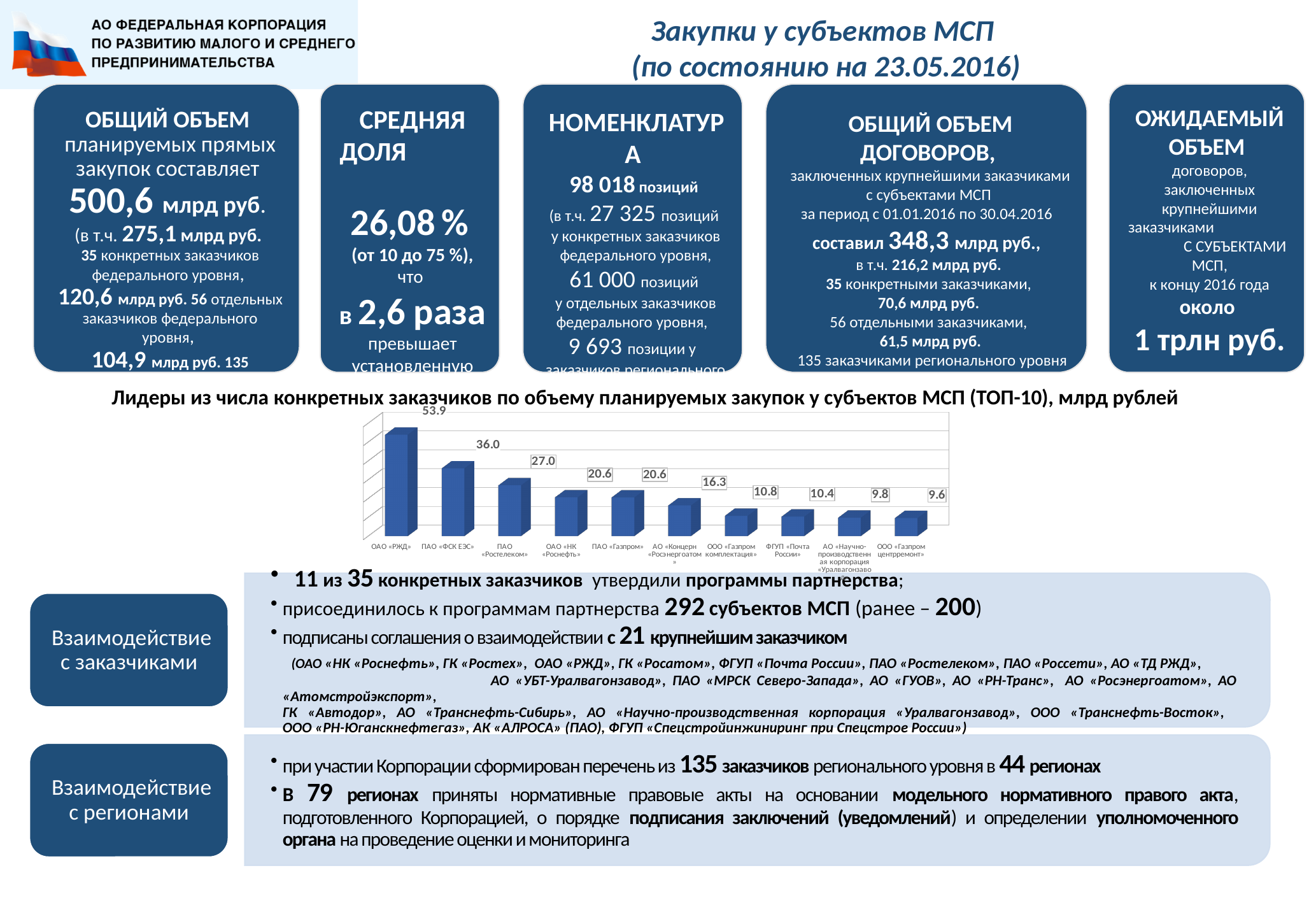
How many customers (categories) are shown in the bar chart? 10 What type of chart is shown on the slide? bar chart What is the difference between the values for ОАО «РЖД» and ПАО «ФСК ЕЭС» in the bar chart? 17.9 Which customer has the highest value in the bar chart? ОАО «РЖД» What is the value for АО «Концерн «Росэнергоатом» in the bar chart? 16.3 What is the value for ПАО «Ростелеком» in the bar chart? 27.0 What is the value for ПАО «ФСК ЕЭС» in the bar chart? 36.0 Do the values in the bar chart rise or fall from left to right? fall Which customer has the lowest value in the bar chart? ООО «Газпром центрремонт» Which is larger in the bar chart: the value for ПАО «Ростелеком» or the value for ПАО «Газпром»? ПАО «Ростелеком» What is the value for ОАО «РЖД» in the bar chart? 53.9 What is the value for ФГУП «Почта России» in the bar chart? 10.4